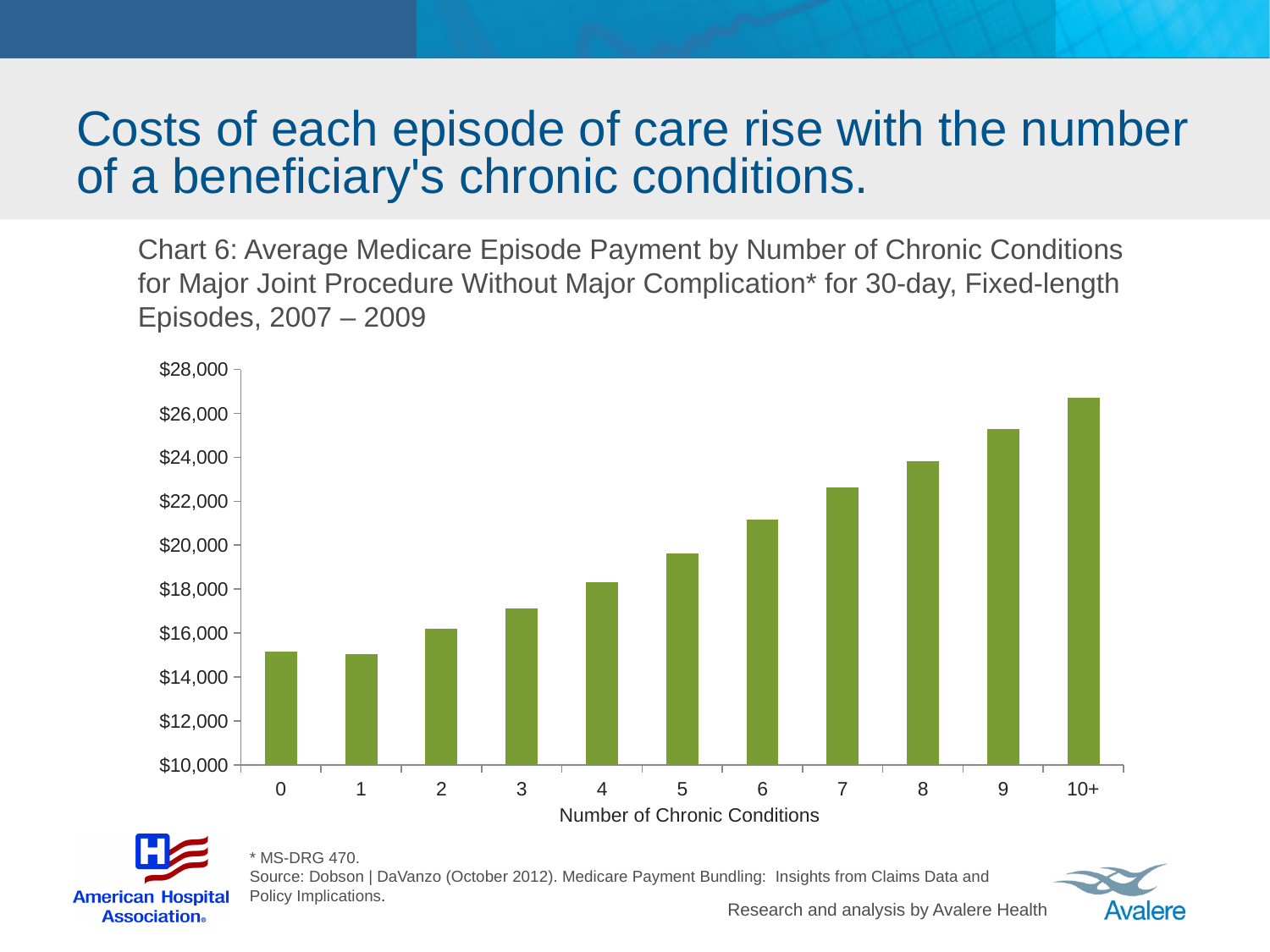
Do the average episode payments generally rise or fall as the number of chronic conditions increases? Rise What is the title of the x axis? Number of Chronic Conditions What kind of chart is shown on the slide? Bar chart How many categories of chronic conditions are shown on the x axis? 11 Is the average episode payment for 5 chronic conditions greater or less than $20,000? less What years does the chart title say the data covers? 2007 – 2009 Which has a higher average episode payment: 4 chronic conditions or 9 chronic conditions? 9 chronic conditions Is the average episode payment for 0 chronic conditions greater or less than $16,000? less Which number of chronic conditions has the highest average Medicare episode payment? 10+ Is the average episode payment for 10+ chronic conditions greater or less than $26,000? greater